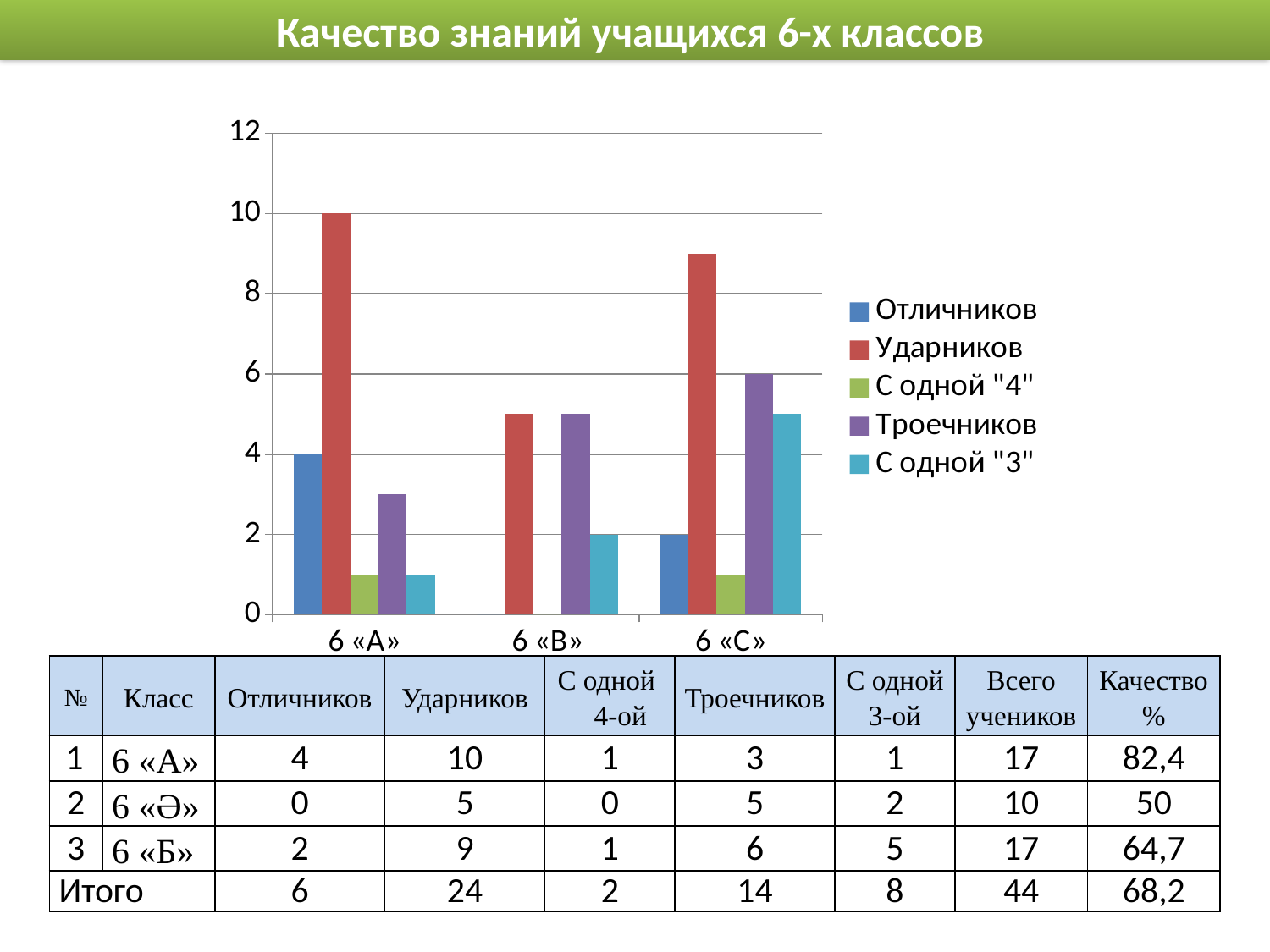
What is the value of Отличников for 6 «А» in the chart? 4 What is the value of Ударников for 6 «А» in the chart? 10 Which is larger in the chart: Троечников for 6 «С» or Троечников for 6 «А»? Троечников for 6 «С» Which class has the highest Ударников bar in the chart? 6 «А» Is the Ударников bar for 6 «С» greater or less than 8? greater What is the difference between the Ударников values for 6 «А» and 6 «В» in the chart? 5 What is the value of Троечников for 6 «С» in the chart? 6 How many series does the chart legend list? 5 What is the value of С одной "3" for 6 «В» in the chart? 2 Which class has the lowest Отличников bar in the chart? 6 «В» What kind of chart is shown on the slide? bar chart How many classes (categories) are shown on the x axis of the chart? 3